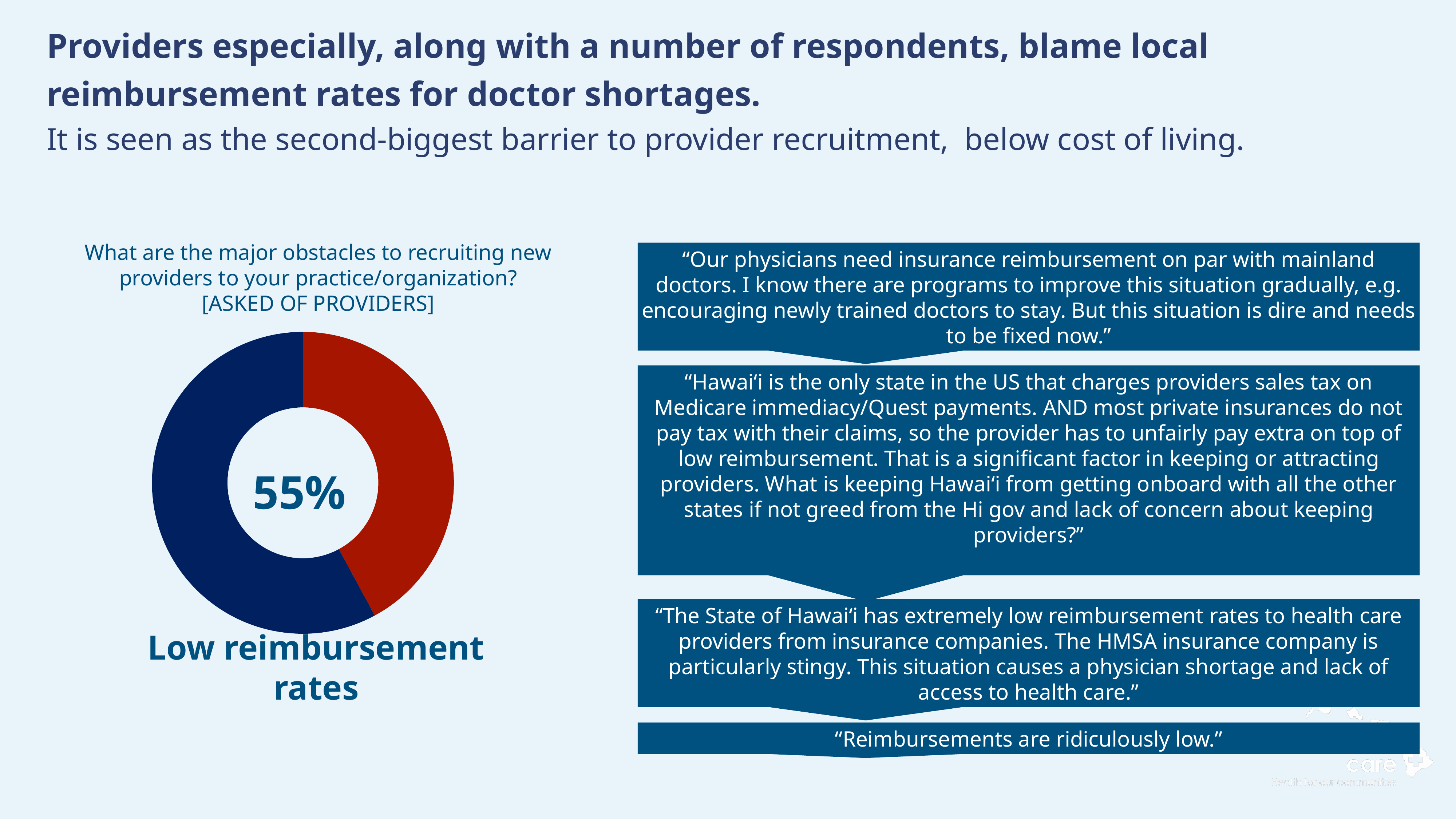
How many slices does the donut chart have? 2 What survey question is the donut chart based on? What are the major obstacles to recruiting new providers to your practice/organization? What kind of chart is shown on the slide? Pie chart (donut) What percentage of providers cited low reimbursement rates as a major obstacle to recruiting new providers? 55% What share of the donut chart does the dark blue slice represent? 55% Which slice of the donut chart is larger, the dark blue one or the red one? The dark blue one What category label is shown beneath the donut chart? Low reimbursement rates Is the value shown in the centre of the donut chart greater or less than 50%? greater